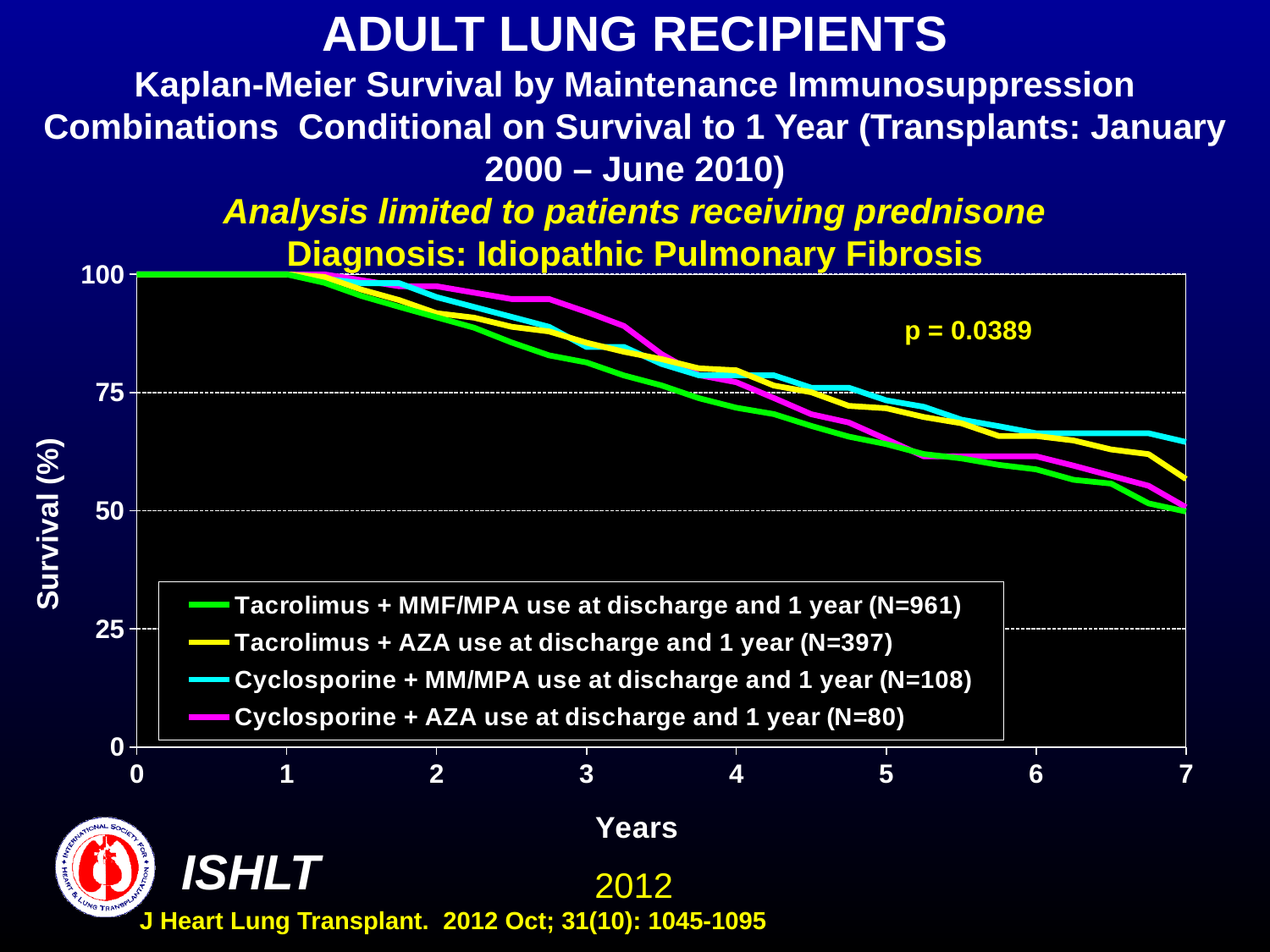
At year 7, which group has the highest survival? Cyclosporine + MM/MPA use at discharge and 1 year Is the survival for Cyclosporine + MM/MPA use at discharge and 1 year at year 7 greater or less than 50? greater At year 2, which has higher survival: Cyclosporine + AZA use at discharge and 1 year or Tacrolimus + MMF/MPA use at discharge and 1 year? Cyclosporine + AZA use at discharge and 1 year At year 7, which has higher survival: Cyclosporine + MM/MPA use at discharge and 1 year or Tacrolimus + MMF/MPA use at discharge and 1 year? Cyclosporine + MM/MPA use at discharge and 1 year What is the N for the Tacrolimus + MMF/MPA use at discharge and 1 year group? N=961 What kind of chart is shown on the slide? line chart How many series does the legend list? 4 Do the survival curves rise or fall as years increase? fall Is the survival for Tacrolimus + AZA use at discharge and 1 year at year 7 greater or less than 50? greater What p-value is printed on the chart? p = 0.0389 Is the survival for Cyclosporine + MM/MPA use at discharge and 1 year at year 4 greater or less than 75? greater